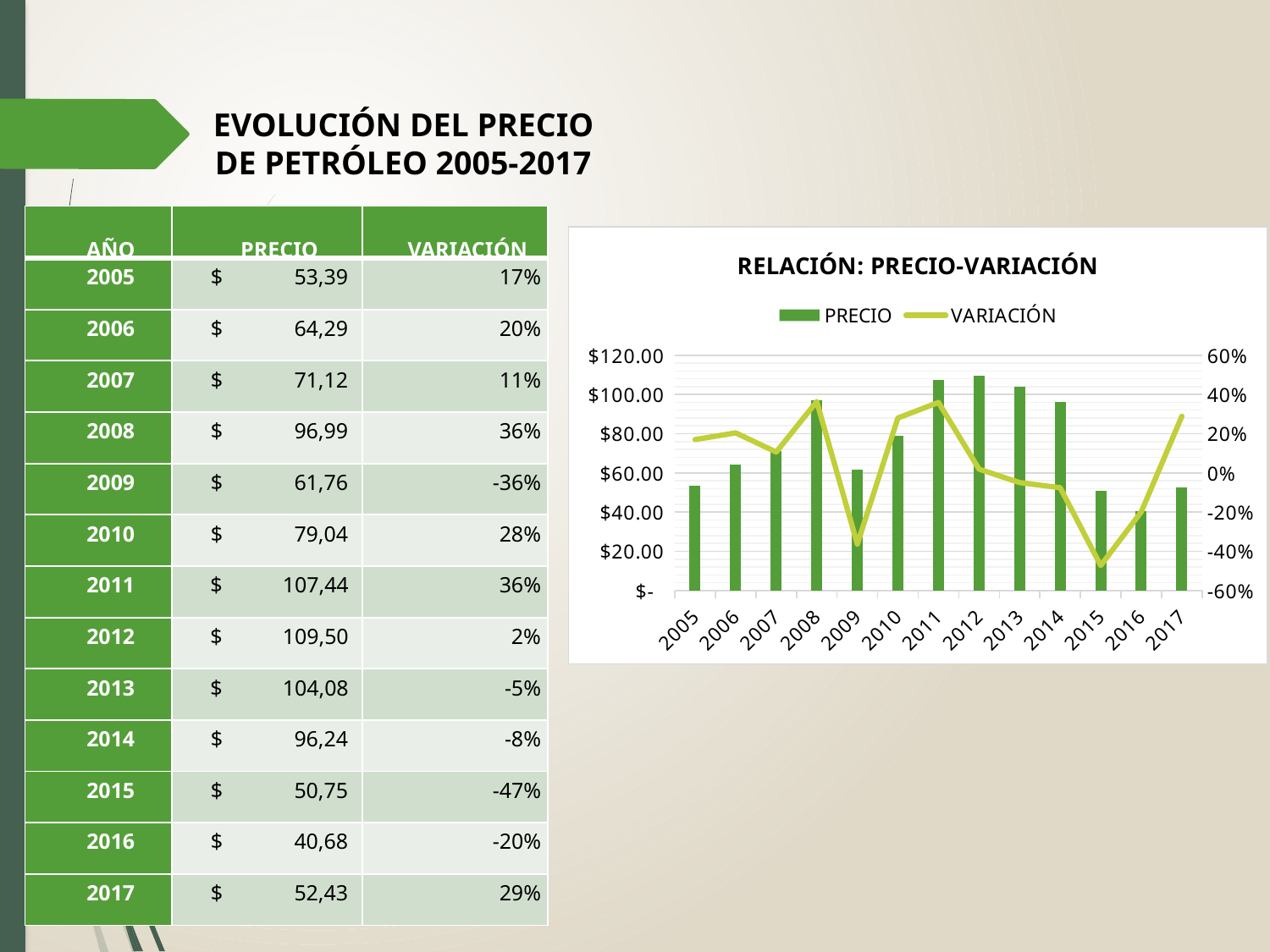
Which year has the lowest point on the VARIACIÓN line? 2015 What kind of chart is shown on the slide? A combined bar and line chart Is the PRECIO value for 2011 greater or less than $100.00? greater How many series does the chart legend list? 2 What is the title of the chart? RELACIÓN: PRECIO-VARIACIÓN Which year has the highest PRECIO bar in the chart? 2012 How many years are plotted along the x axis of the chart? 13 Is the PRECIO value for 2016 greater or less than $60.00? less Which year has the larger PRECIO bar, 2008 or 2009? 2008 Does the PRECIO series rise or fall from 2012 to 2016? It falls Which year has the lowest PRECIO bar in the chart? 2016 What is the VARIACIÓN value for 2009 shown on the slide? -36%